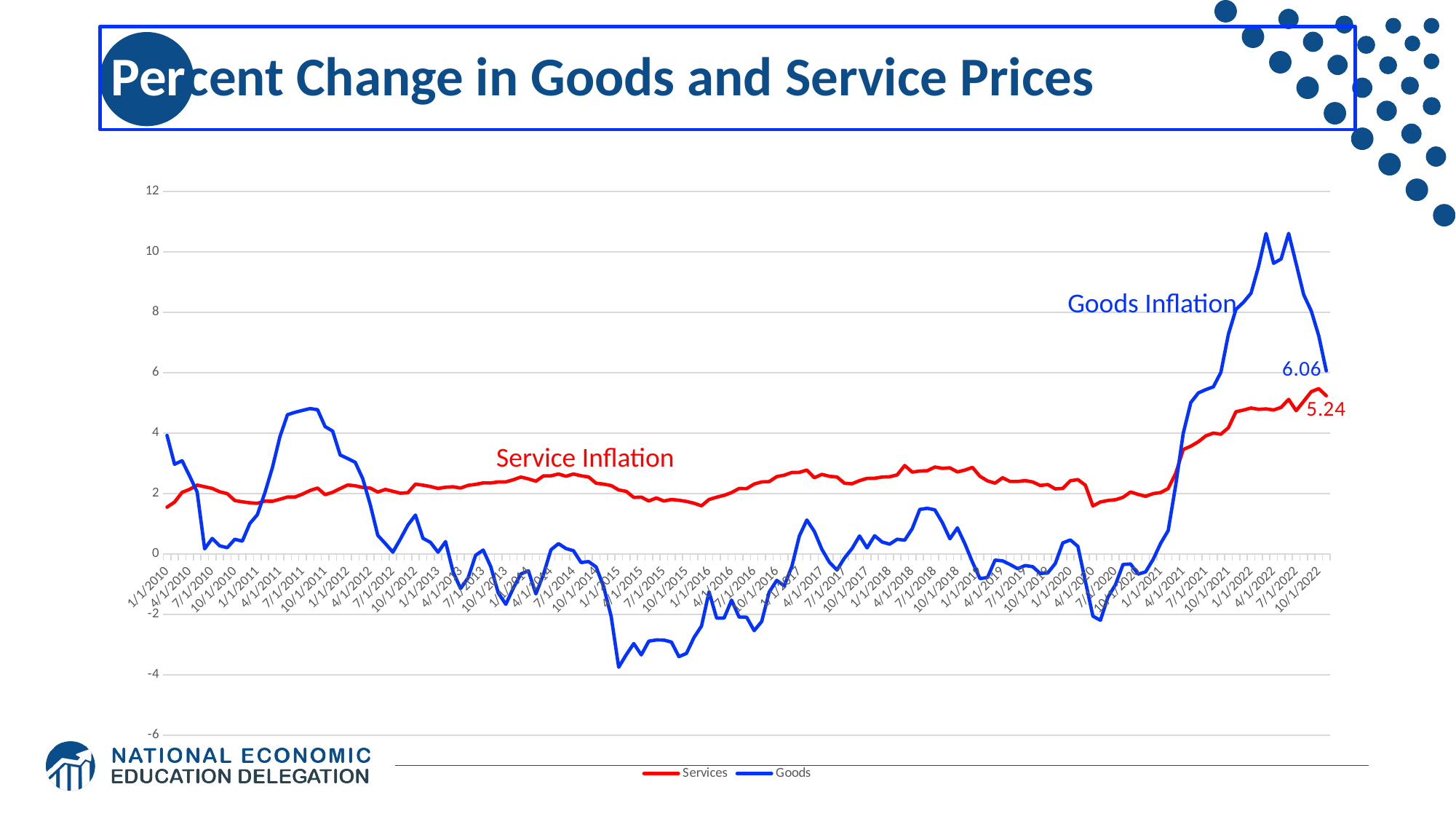
Is the value of the Services line at 1/1/2010 greater or less than 2? less What kind of chart is shown on the slide? line chart What are the two entries in the chart legend? Services and Goods What is the labelled final value of the Goods line? 6.06 How many series does the legend list? 2 What is the difference between the labelled final values of Goods (6.06) and Services (5.24)? 0.82 At the final labelled point, which series has the larger value, Goods or Services? Goods Between 7/1/2022 and 10/1/2022, does the Goods line rise or fall? fall Is the lowest value of the Goods line, around 1/1/2015, greater or less than -2? less What is the labelled final value of the Services line? 5.24 Which series reaches the higher peak value over the whole period, Goods or Services? Goods Is the peak value of the Goods line in 2022 greater or less than 10? greater